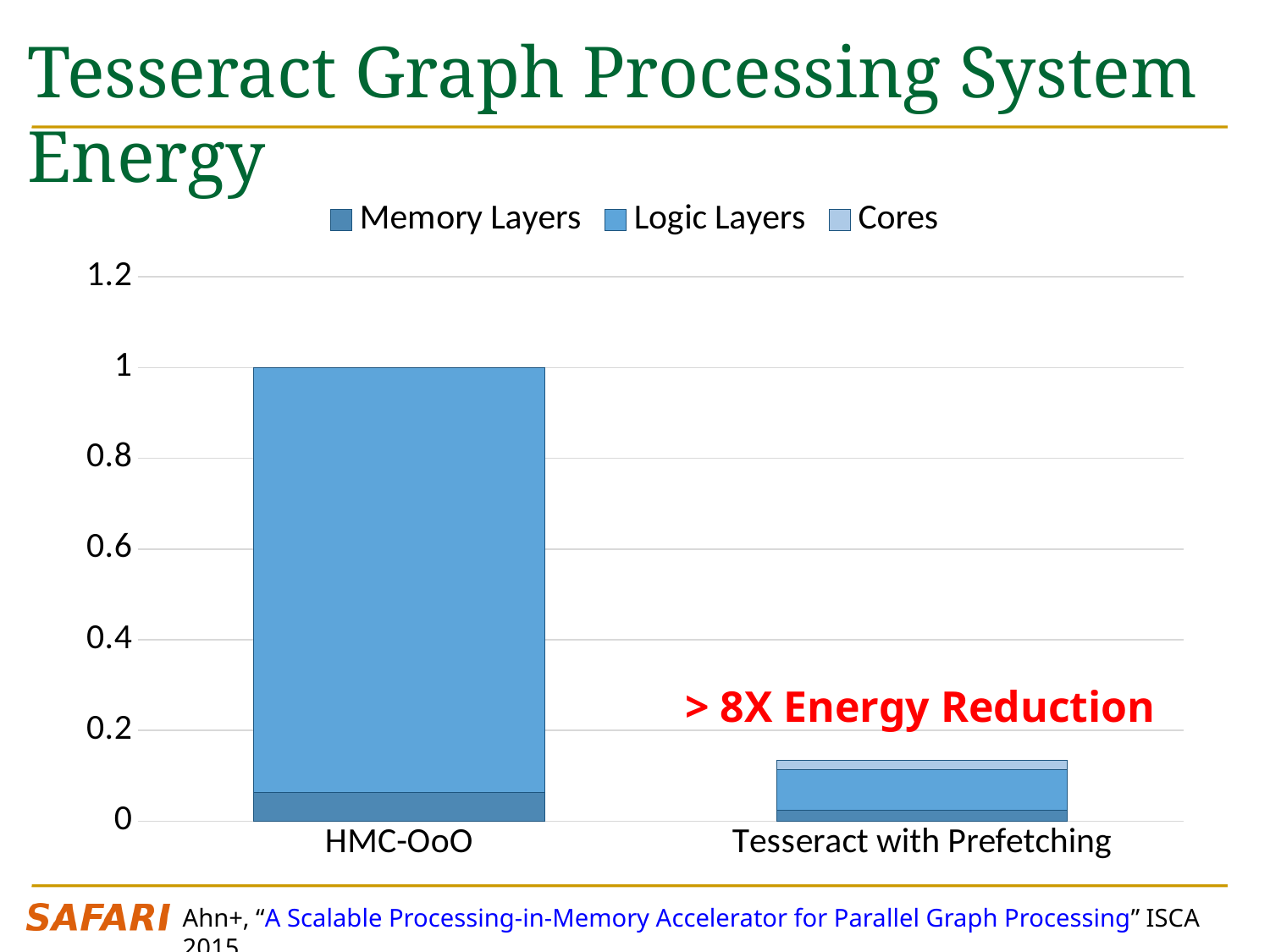
Is the total value for Tesseract with Prefetching greater or less than 0.2? less What are the three series named in the legend? Memory Layers, Logic Layers, Cores How many categories are plotted along the x axis? 2 Which has the larger total bar, HMC-OoO or Tesseract with Prefetching? HMC-OoO Which category has the lowest total energy? Tesseract with Prefetching What kind of chart is shown on the slide? Stacked bar chart Is the Memory Layers segment of the HMC-OoO bar greater or less than 0.2? less Which category has the highest total energy? HMC-OoO Is the total value for HMC-OoO greater or less than 0.8? greater What is the total height of the HMC-OoO stacked bar? 1 What does the red annotation on the chart say? > 8X Energy Reduction How many series does the legend list? 3